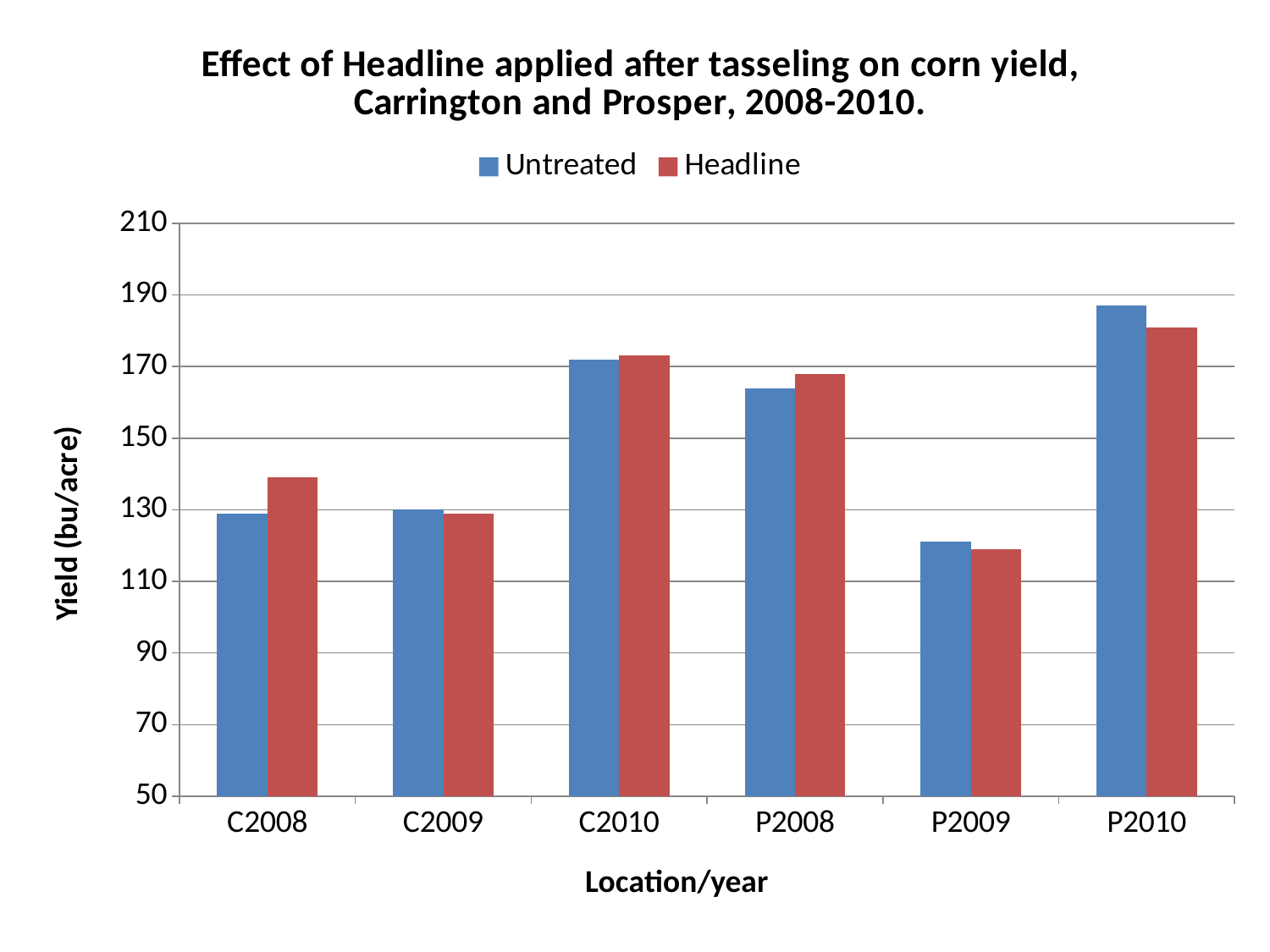
How many location/year categories are shown on the x axis? 6 Is the Headline value for C2008 greater or less than 130? greater Which category and series has the highest yield? P2010 Untreated How many series does the legend list? 2 For C2008, which is larger, the Untreated or the Headline yield? Headline What is the label of the y axis? Yield (bu/acre) What kind of chart is shown on the slide? bar chart Is the Untreated value for P2009 greater or less than 130? less For P2010, which is larger, the Untreated or the Headline yield? Untreated For P2008, which is larger, the Untreated or the Headline yield? Headline Which category and series has the lowest yield? P2009 Headline Is the Untreated value for P2010 greater or less than 170? greater